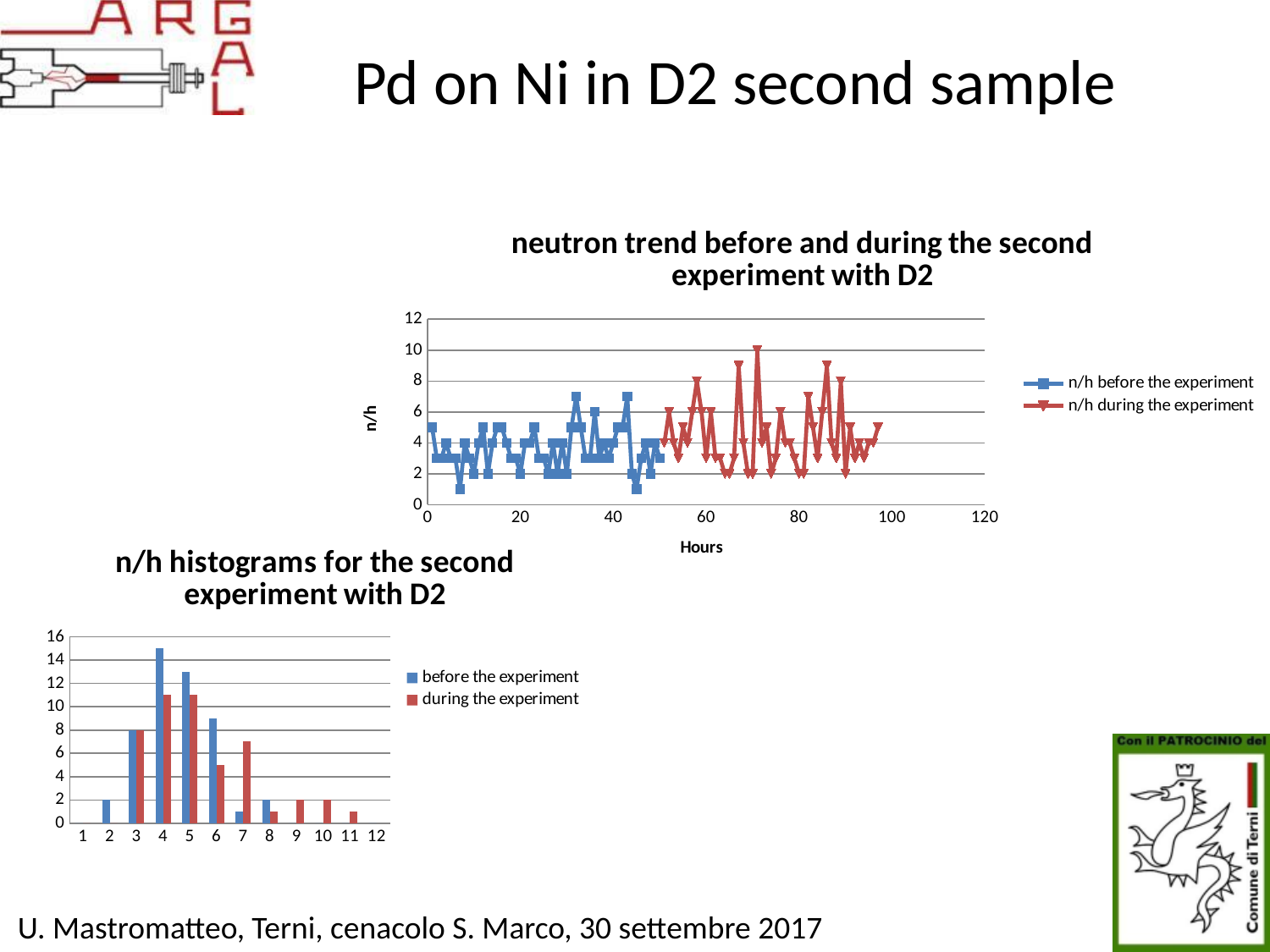
What type of chart is the 'n/h histograms for the second experiment with D2' chart? bar chart In the 'n/h histograms for the second experiment with D2' chart, what is the value of 'before the experiment' for category 3? 8 How many categories are shown on the x-axis of the 'n/h histograms for the second experiment with D2' chart? 12 In the 'neutron trend before and during the second experiment with D2' chart, what is the x-axis title? Hours In the 'neutron trend before and during the second experiment with D2' chart, which series reaches the higher peak value? n/h during the experiment In the 'neutron trend before and during the second experiment with D2' chart, is the highest value of the 'n/h during the experiment' series greater or less than 8? greater What type of chart is the 'neutron trend before and during the second experiment with D2' chart? line chart In the 'n/h histograms for the second experiment with D2' chart, is the 'before the experiment' value for category 4 greater or less than 14? greater In the 'n/h histograms for the second experiment with D2' chart, what is the value of 'during the experiment' for category 10? 2 How many series does the legend of the 'neutron trend before and during the second experiment with D2' chart list? 2 In the 'neutron trend before and during the second experiment with D2' chart, is the highest value of the 'n/h before the experiment' series greater or less than 8? less In the 'n/h histograms for the second experiment with D2' chart, which category has the highest 'before the experiment' value? 4